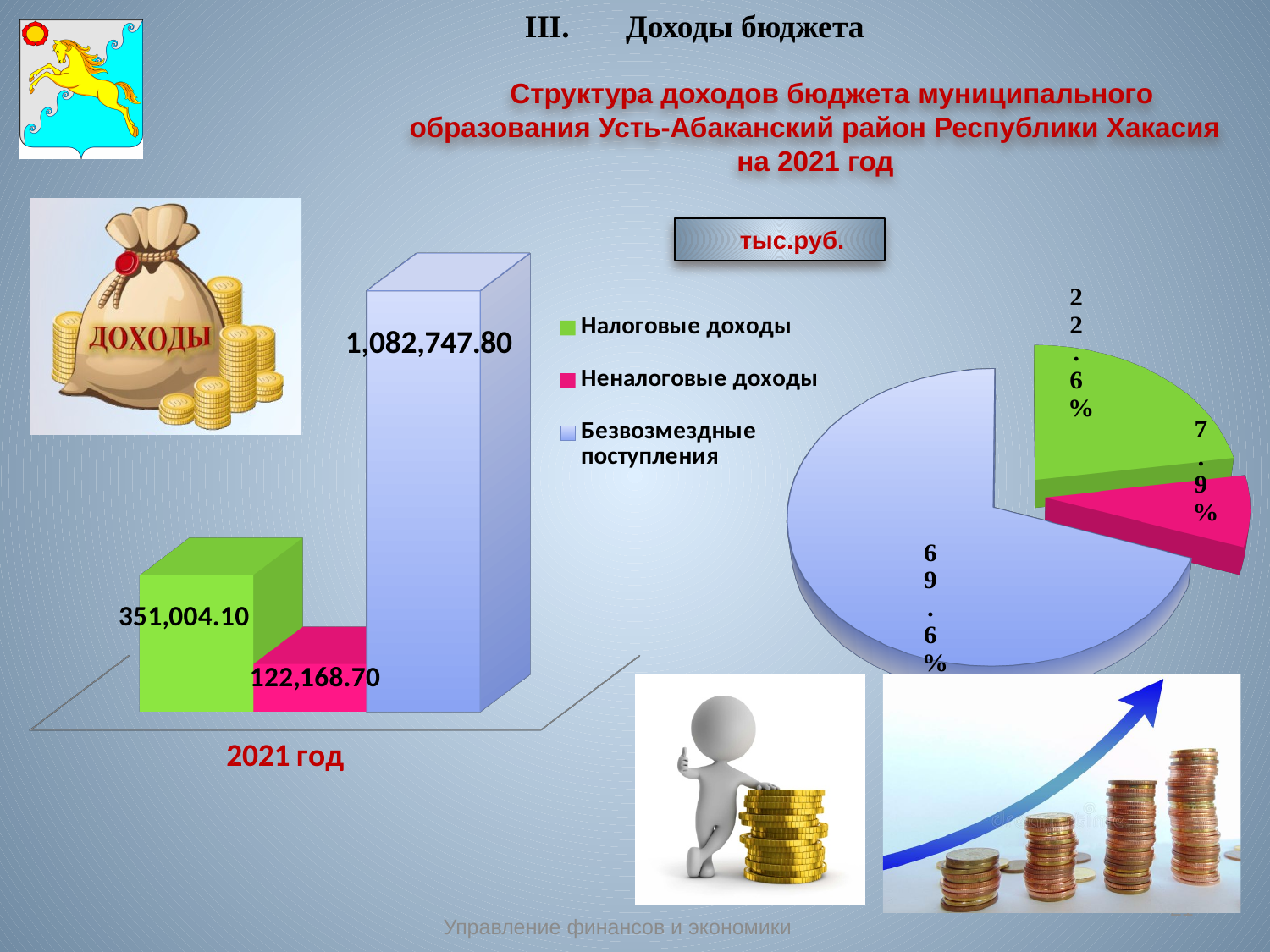
How many series does the legend of the bar chart on the left list? 3 On the bar chart on the left, what is the value for Безвозмездные поступления? 1,082,747.80 What kind of chart is the chart on the right of the slide? Pie chart On the pie chart on the right, what share does the blue slice (Безвозмездные поступления) have? 69.6% On the bar chart on the left, which series has the highest value? Безвозмездные поступления On the pie chart on the right, what share does the green slice (Налоговые доходы) have? 22.6% On the bar chart on the left, which series has the lowest value? Неналоговые доходы On the bar chart on the left, what is the difference between Налоговые доходы and Неналоговые доходы? 228,835.40 On the bar chart on the left, which is larger: Налоговые доходы or Неналоговые доходы? Налоговые доходы On the bar chart on the left, what is the value for Налоговые доходы? 351,004.10 What kind of chart is the chart on the left of the slide? Bar chart On the bar chart on the left, what is the value for Неналоговые доходы? 122,168.70